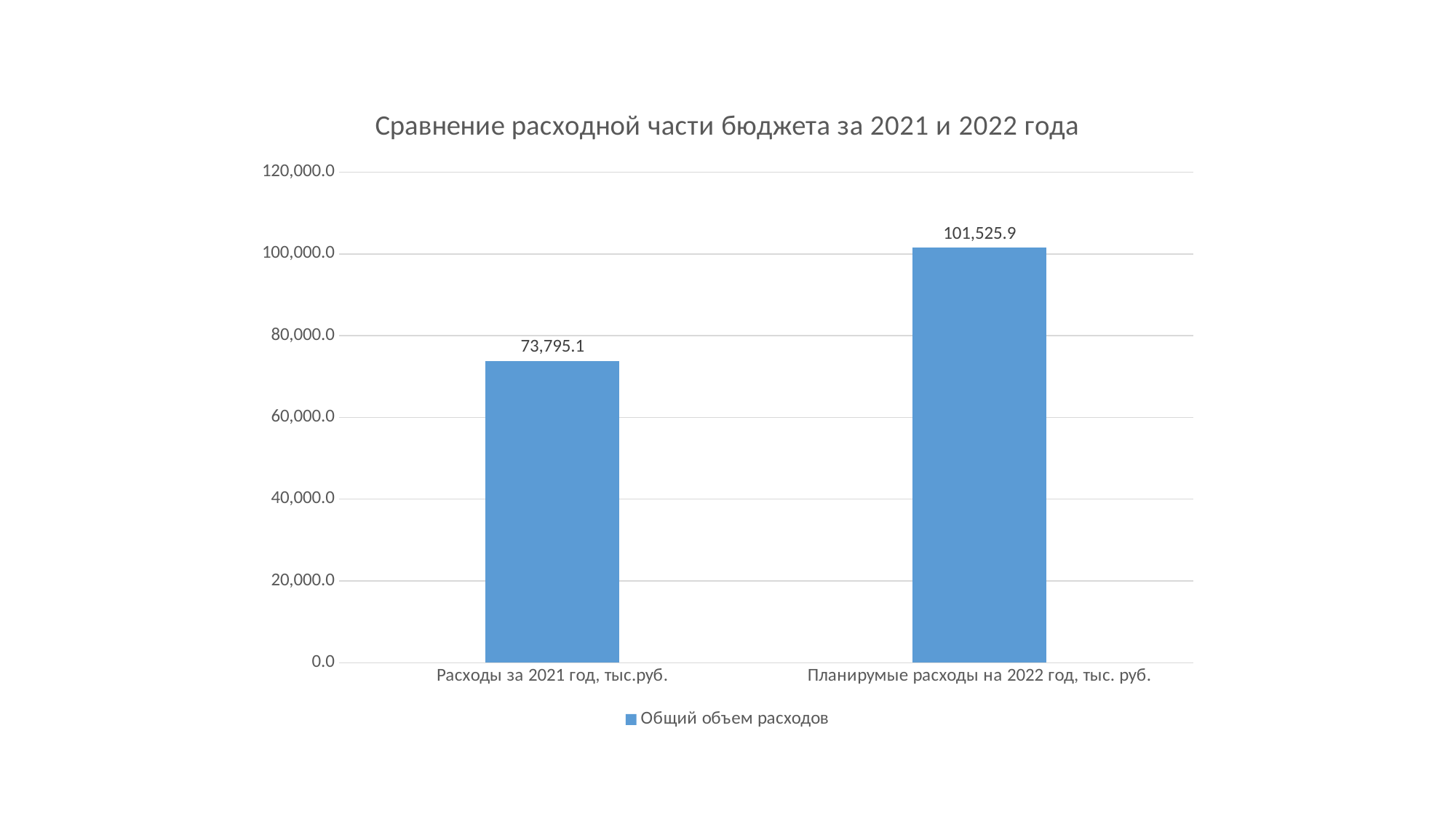
Is the value for "Планирумые расходы на 2022 год, тыс. руб." greater or less than 100,000.0? greater What is the title of the chart? Сравнение расходной части бюджета за 2021 и 2022 года Which is larger: the value for 2021 expenses or the value for planned 2022 expenses? Планирумые расходы на 2022 год, тыс. руб. What is the difference between the planned 2022 expenses and the 2021 expenses? 27,730.8 How many series does the legend list? 1 How many categories are shown on the x axis? 2 What is the value for "Расходы за 2021 год, тыс.руб."? 73,795.1 What is the value for "Планирумые расходы на 2022 год, тыс. руб."? 101,525.9 Is the value for "Расходы за 2021 год, тыс.руб." greater or less than 80,000.0? less Which category has the lowest value? Расходы за 2021 год, тыс.руб. Which category has the highest value? Планирумые расходы на 2022 год, тыс. руб. What kind of chart is shown on the slide? bar chart